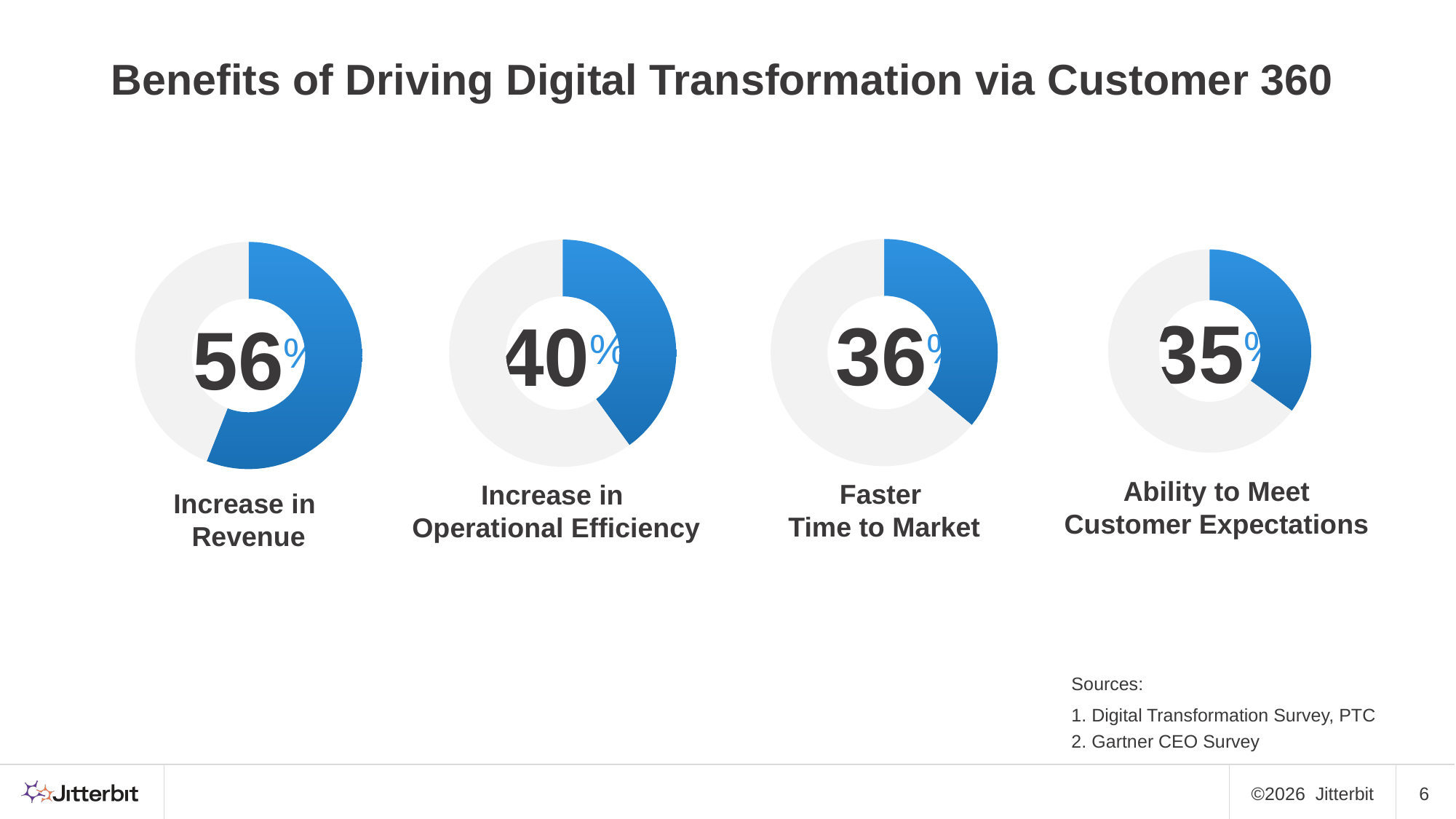
What kind of chart is used to show each benefit? Donut chart What is the title of the slide? Benefits of Driving Digital Transformation via Customer 360 What is the difference between the percentages for Faster Time to Market and Ability to Meet Customer Expectations? 1% What percentage is shown for Increase in Operational Efficiency? 40% What is the difference between the percentages for Increase in Revenue and Increase in Operational Efficiency? 16% Which benefit has the highest percentage? Increase in Revenue How many donut charts are shown on the slide? 4 What percentage is shown for Increase in Revenue? 56% What percentage is shown for Faster Time to Market? 36% Which benefit has the lowest percentage? Ability to Meet Customer Expectations Which is larger: the percentage for Increase in Operational Efficiency or for Faster Time to Market? Increase in Operational Efficiency What percentage is shown for Ability to Meet Customer Expectations? 35%